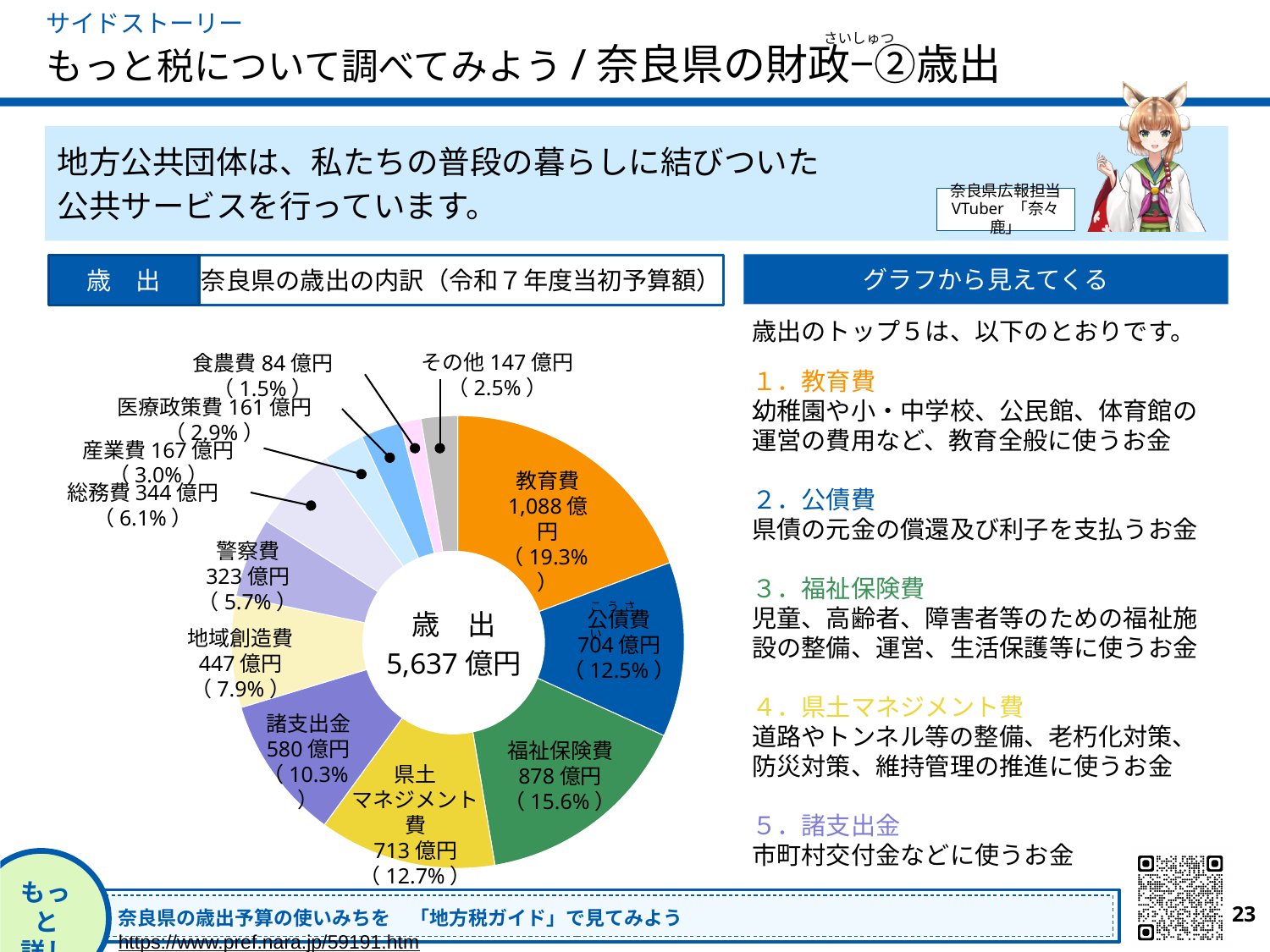
奈良県の歳出の内訳グラフで、教育費と福祉保険費の金額の差はいくらですか？ 210億円 奈良県の歳出の内訳グラフで、福祉保険費の割合は何％ですか？ 15.6% 奈良県の歳出の内訳グラフには、いくつの費目が示されていますか？ 12 このグラフはどの種類のグラフですか？ 円グラフ（ドーナツグラフ） 奈良県の歳出の内訳グラフで、最も金額が大きい費目はどれですか？ 教育費 奈良県の歳出の内訳グラフで、公債費と県土マネジメント費ではどちらの金額が大きいですか？ 県土マネジメント費 奈良県の歳出の内訳グラフで、諸支出金が歳出全体に占める割合は何％ですか？ 10.3% このグラフは何年度の予算額を示していますか？ 令和7年度当初予算額 奈良県の歳出の内訳グラフで、教育費の金額はいくらですか？ 1,088億円 奈良県の歳出の内訳グラフで、最も金額が小さい費目はどれですか？ 食農費 奈良県の歳出の内訳グラフで、警察費の金額はいくらですか？ 323億円 奈良県の歳出の内訳グラフで、歳出の合計額はいくらですか？ 5,637億円